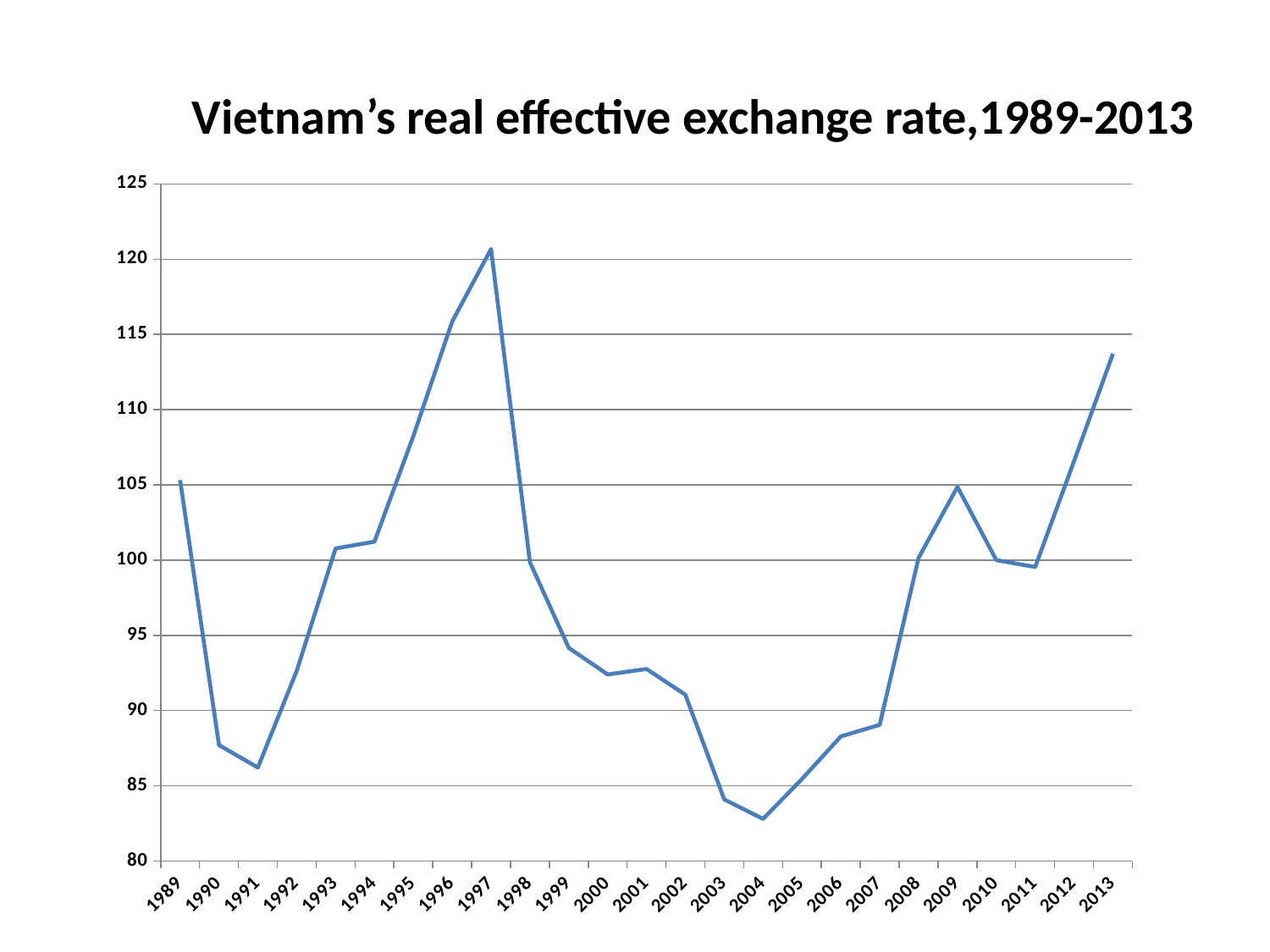
Which year has the larger value, 1997 or 2013? 1997 Is the value for 2013 greater or less than 110? greater What kind of chart is shown on the slide? line chart How many years are plotted along the x axis? 25 What is the title of the chart? Vietnam's real effective exchange rate,1989-2013 Does the real effective exchange rate rise or fall between 1997 and 2004? fall In which year does the real effective exchange rate reach its lowest value? 2004 In which year does the real effective exchange rate reach its highest value? 1997 Is the value for 1991 greater or less than 90? less Is the value for 1997 greater or less than 115? greater Which year has the larger value, 1990 or 2004? 1990